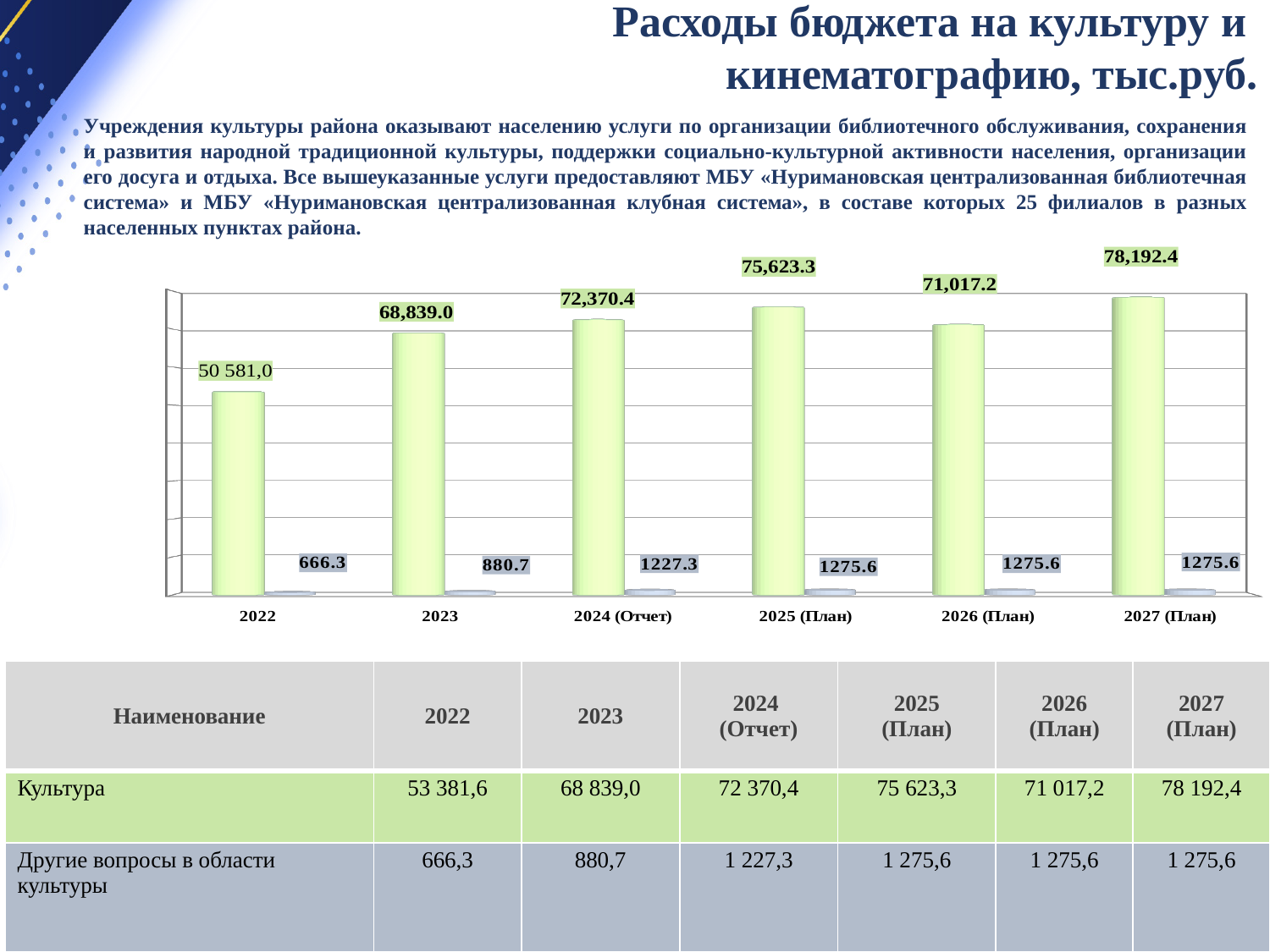
What is the value of the tall green bar for 2025 (План)? 75,623.3 What is the value of the tall green bar for 2022 as labelled on the chart? 50 581,0 Which year has the lowest tall green bar? 2022 Which year has the highest tall green bar? 2027 (План) What kind of chart is shown on the slide? bar chart What is the difference between the small bar values for 2023 and 2022? 214.4 Do the tall green bars rise or fall from 2022 to 2025 (План)? rise What is the difference between the tall green bar values for 2027 (План) and 2026 (План)? 7,175.2 What is the value of the tall green bar for 2023? 68,839.0 How many year categories are shown along the x axis of the chart? 6 Which is larger, the tall green bar for 2024 (Отчет) or for 2026 (План)? 2024 (Отчет) What is the value of the small bar for 2024 (Отчет)? 1227.3